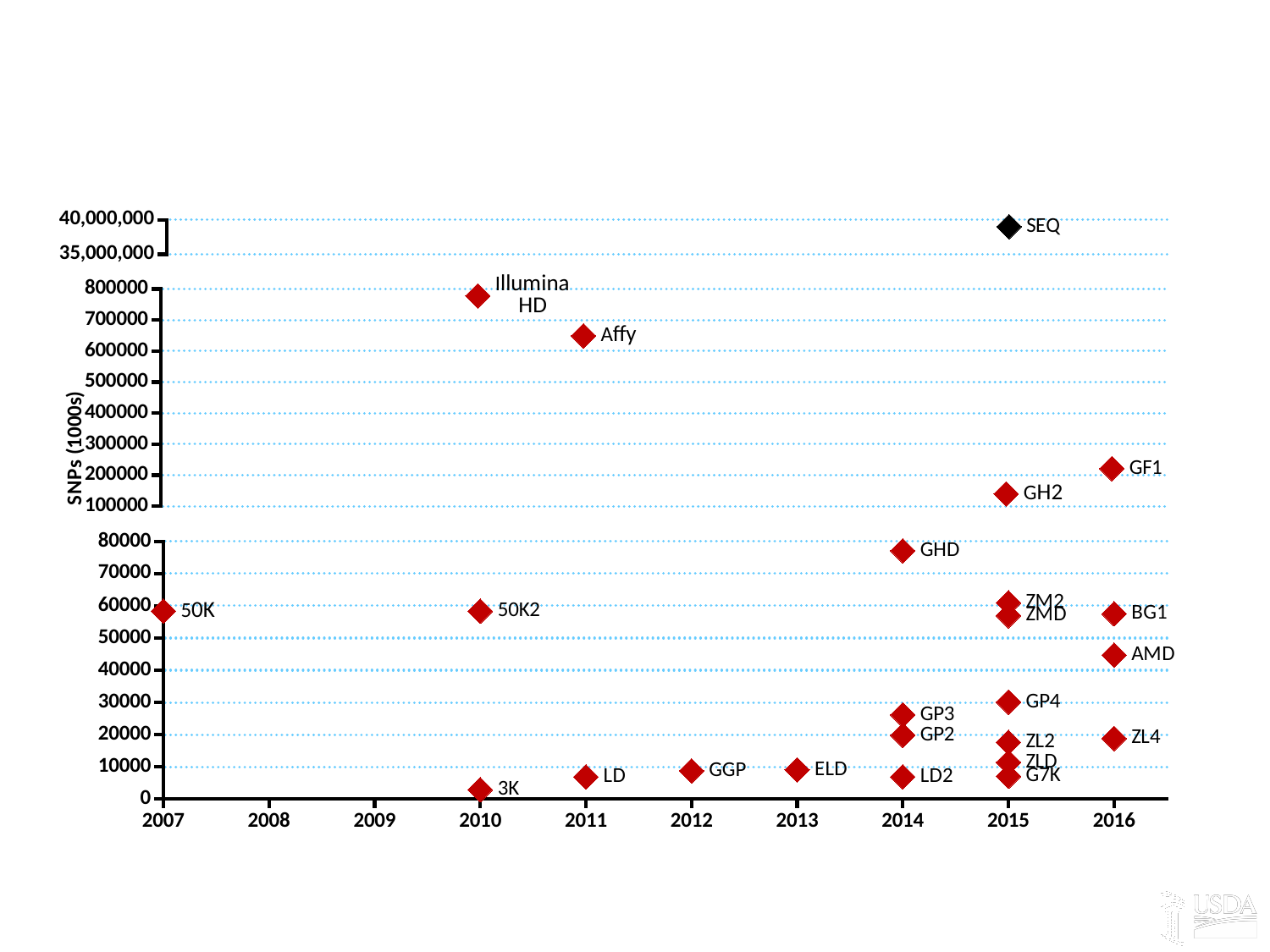
Which is higher, Illumina HD or Affy? Illumina HD Is the value for AMD greater or less than 40000? greater Is the value for 3K greater or less than 10000? less Which point has the highest SNP value on the chart? SEQ What is the label of the y axis? SNPs (1000s) What kind of chart is shown on the slide? scatter chart Is the value for GHD greater or less than 70000? greater In which year is GGP plotted? 2012 Which point has the lowest SNP value on the chart? 3K Which year has the most points plotted? 2015 In which year is ELD plotted? 2013